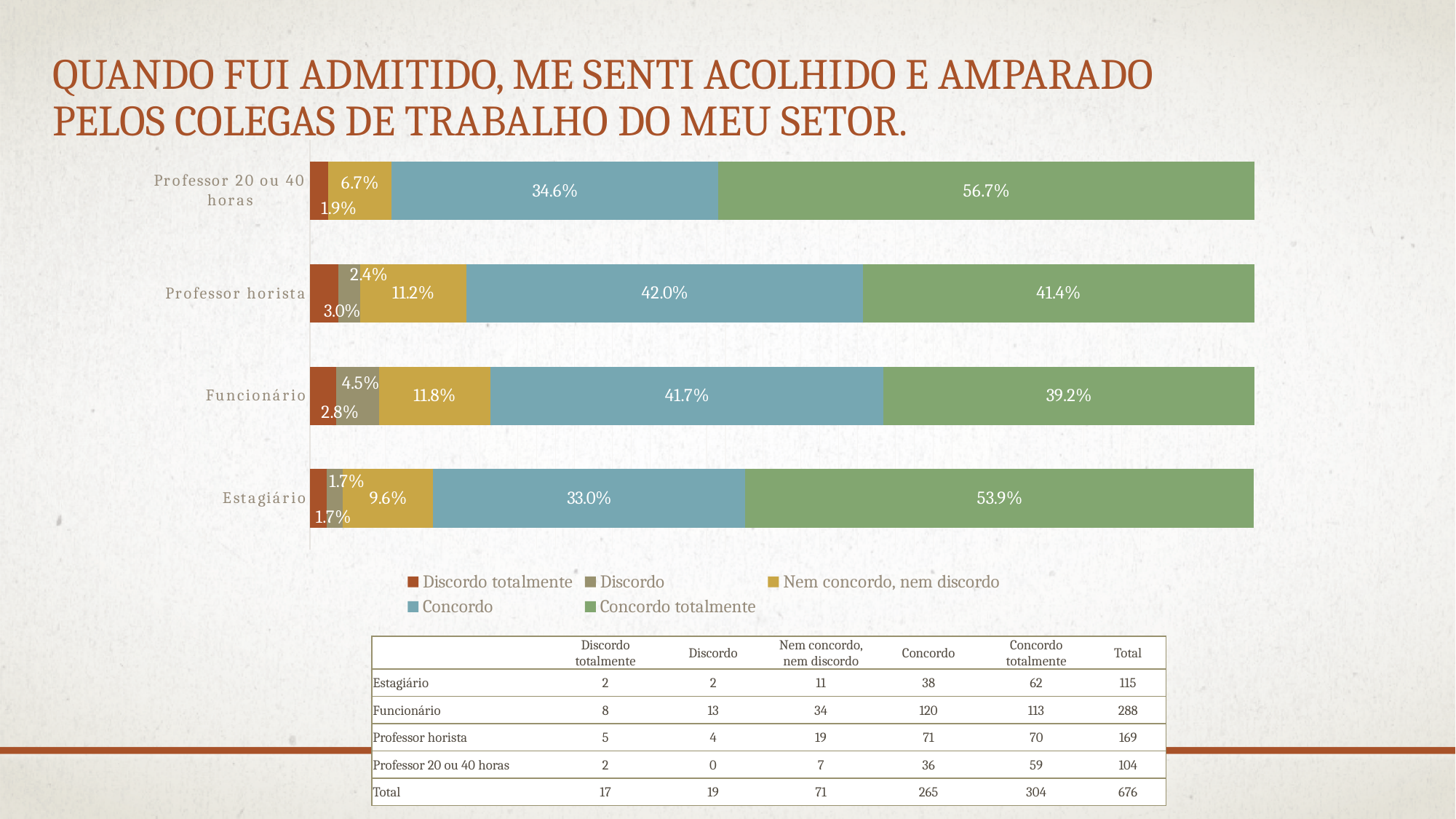
What is the value of "Concordo totalmente" for "Professor 20 ou 40 horas"? 56.7% Which category has the lowest "Concordo" value? Estagiário What is the value of "Discordo" for "Estagiário"? 1.7% What is the value of "Concordo" for "Professor horista"? 42.0% What colour represents "Concordo totalmente" in the legend? Green How many categories are shown in the chart? 4 How many series does the legend list? 5 Which category has the highest "Concordo totalmente" value? Professor 20 ou 40 horas What is the value of "Nem concordo, nem discordo" for "Funcionário"? 11.8% What kind of chart is shown on the slide? Stacked bar chart For "Funcionário", which is larger: "Concordo" or "Concordo totalmente"? Concordo What is the difference between the "Concordo totalmente" values for "Professor 20 ou 40 horas" and "Estagiário"? 2.8%